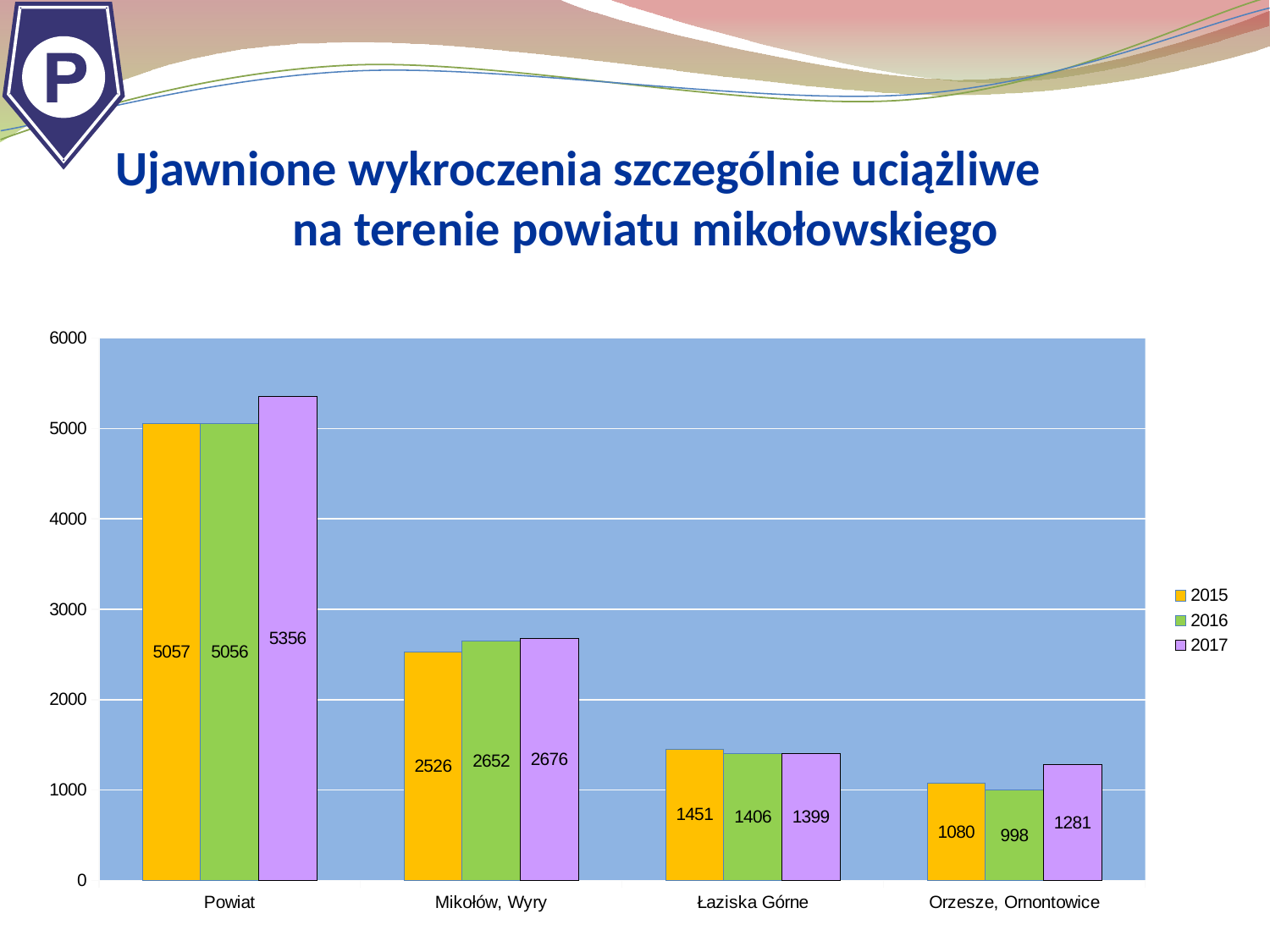
How many categories are shown on the x axis? 4 Which is larger for Mikołów, Wyry: the 2015 value or the 2017 value? 2017 What is the value for Powiat in 2017? 5356 What is the difference between the 2017 and 2015 values for Powiat? 299 Which category has the highest value in 2015? Powiat How many series does the legend list? 3 What kind of chart is shown on the slide? bar chart Which colour represents the 2017 series in the legend? purple What is the value for Orzesze, Ornontowice in 2016? 998 Which category has the lowest value in 2016? Orzesze, Ornontowice What is the value for Łaziska Górne in 2015? 1451 What is the difference between the 2017 and 2016 values for Orzesze, Ornontowice? 283